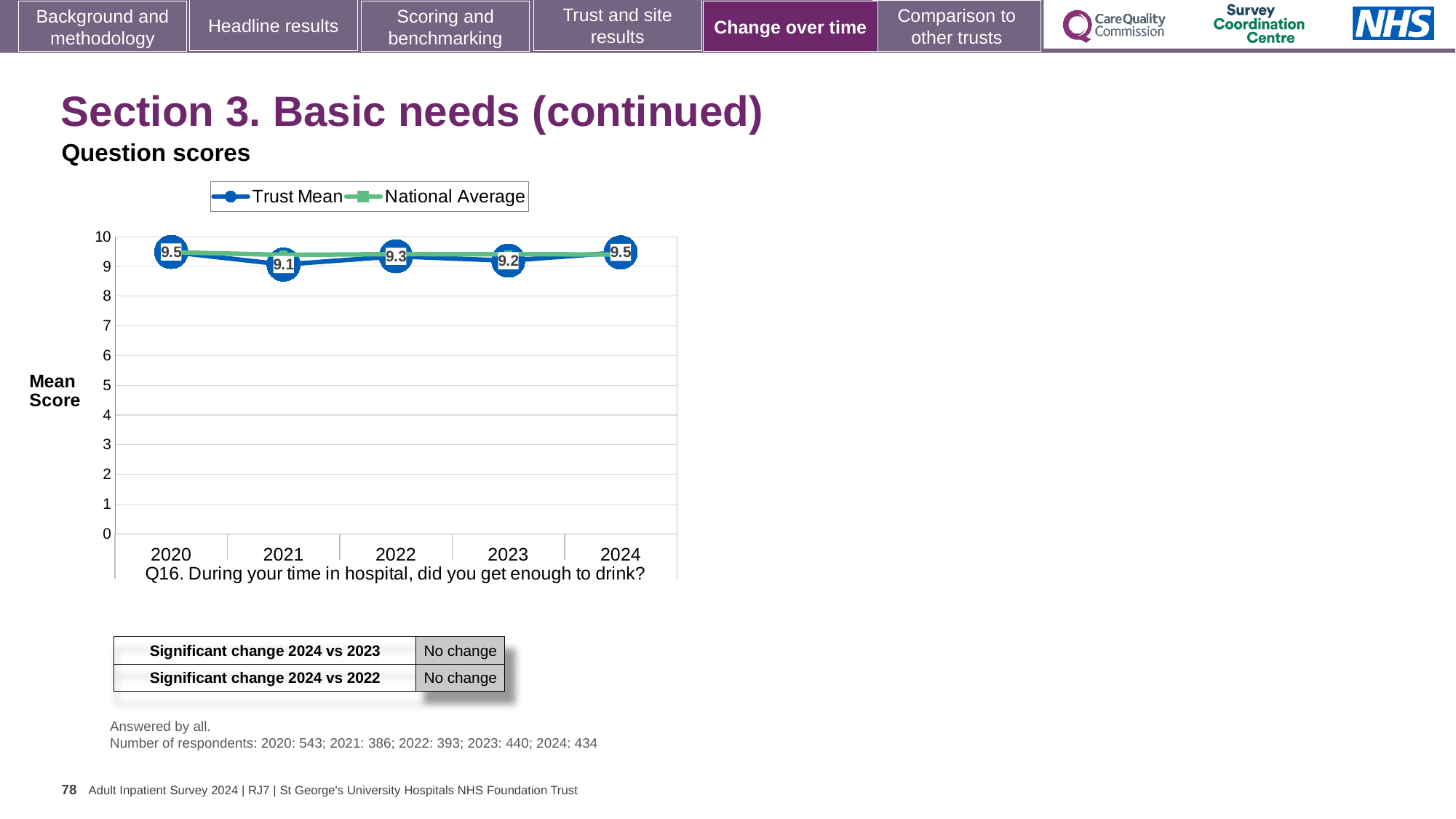
How many series does the legend list? 2 What is the difference between the Trust Mean scores for 2024 and 2021? 0.4 What is the Trust Mean score for 2024? 9.5 Does the Trust Mean score rise or fall from 2023 to 2024? Rise Which year has the higher Trust Mean score, 2022 or 2023? 2022 What is the label on the y axis of the chart? Mean Score Is the National Average value for 2021 greater or less than 9? greater In which year is the Trust Mean score lowest? 2021 What kind of chart is shown on the slide? Line chart What is the Trust Mean score for 2021? 9.1 What is the Trust Mean score for 2022? 9.3 How many years are plotted on the x axis? 5